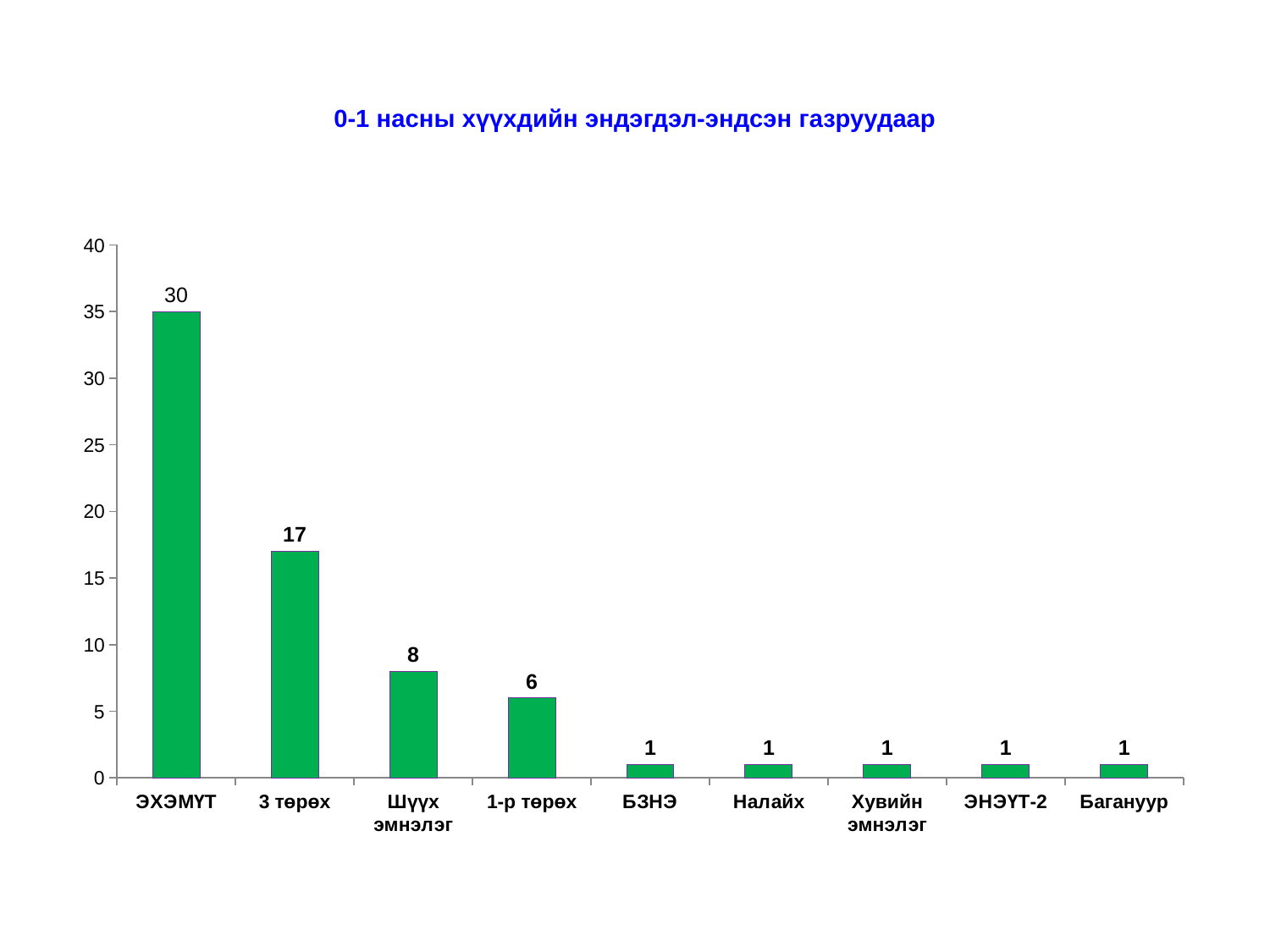
What is the value for Шүүх эмнэлэг? 8 What is the value for 1-р төрөх? 6 Which category has the highest value in the chart? ЭХЭМҮТ How many categories are shown on the x axis of the chart? 9 What kind of chart is shown on the slide? bar chart Which is larger, the value for 3 төрөх or the value for 1-р төрөх? 3 төрөх What is the value for 3 төрөх? 17 What is the title of the chart? 0-1 насны хүүхдийн эндэгдэл-эндсэн газруудаар What is the difference between the values for Шүүх эмнэлэг and 1-р төрөх? 2 Is the value for ЭХЭМҮТ greater or less than 25? greater What is the value for Багануур? 1 What is the difference between the values for 3 төрөх and Шүүх эмнэлэг? 9